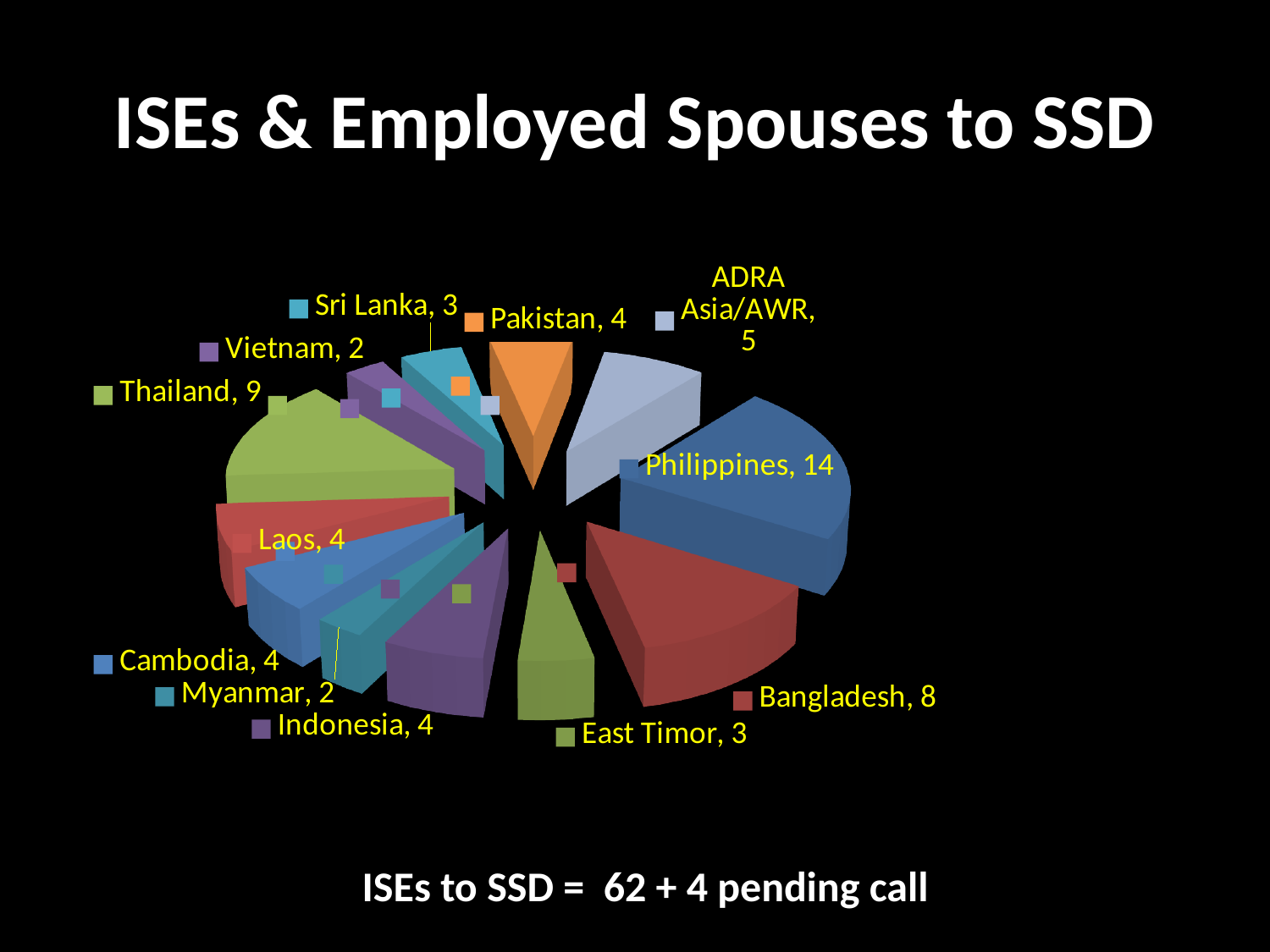
What is the difference between the values for Philippines and Bangladesh? 6 What kind of chart is shown on the slide? Pie chart What is the difference between the values for Thailand and Sri Lanka? 6 What is the value for East Timor? 3 Which category has the largest slice of the pie? Philippines What is the value for ADRA Asia/AWR? 5 Which is larger, the value for Thailand or the value for Bangladesh? Thailand What is the value for Philippines? 14 What is the value for Thailand? 9 Which categories have the smallest value in the pie chart? Myanmar and Vietnam How many categories are shown in the pie chart? 12 What is the title of the slide? ISEs & Employed Spouses to SSD